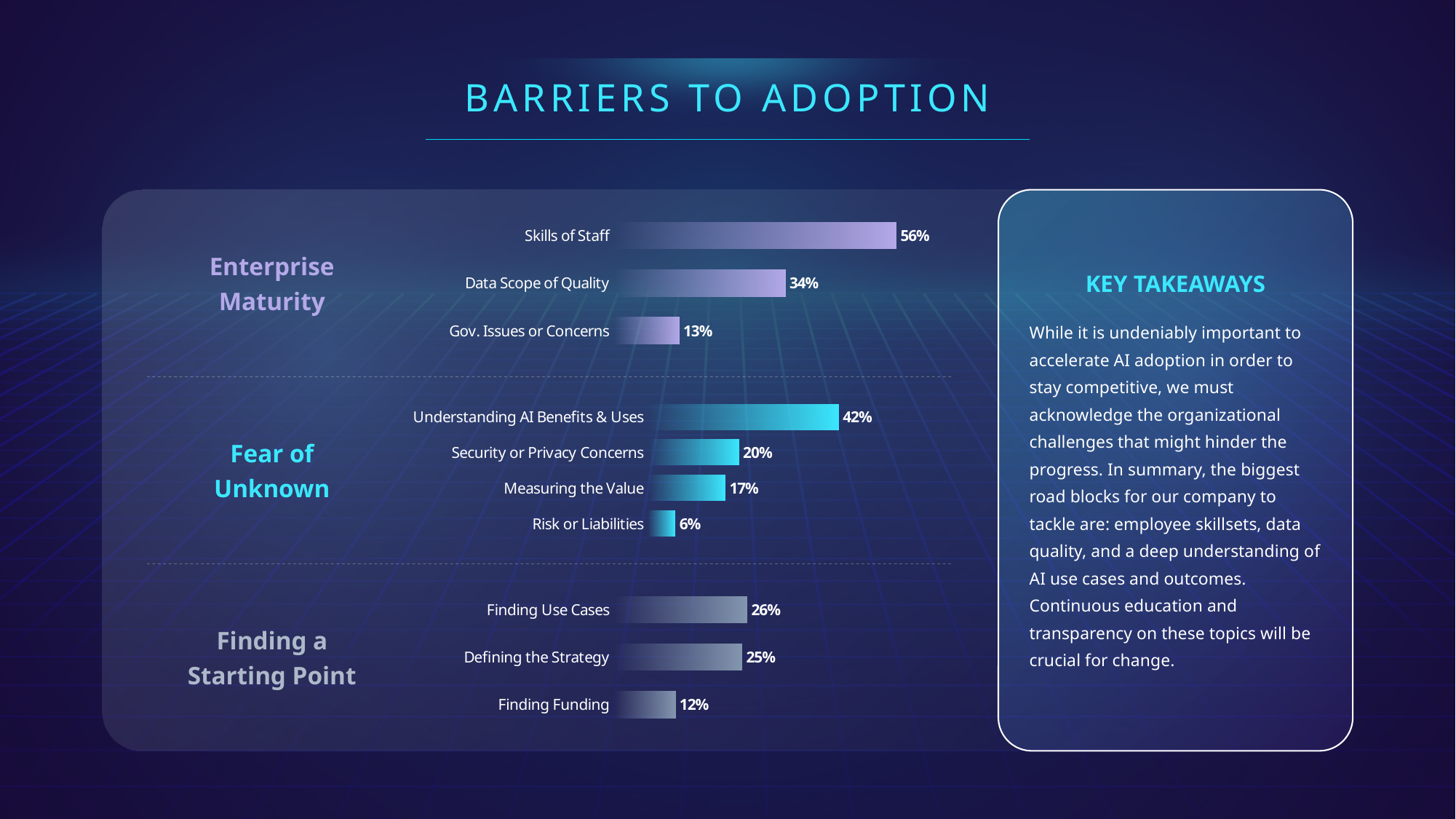
How many categories are shown in the Fear of Unknown chart? 4 What kind of chart is used in the Finding a Starting Point section? Bar chart In the Fear of Unknown chart, which is larger: Measuring the Value or Security or Privacy Concerns? Security or Privacy Concerns In the Finding a Starting Point chart, what is the difference between Finding Use Cases and Finding Funding? 14% In the Fear of Unknown chart, which category has the highest value? Understanding AI Benefits & Uses What is the title of the slide containing the charts? Barriers to Adoption In the Enterprise Maturity chart, what is the value for Skills of Staff? 56% In the Fear of Unknown chart, what is the value for Security or Privacy Concerns? 20% In the Fear of Unknown chart, which category has the lowest value? Risk or Liabilities In the Finding a Starting Point chart, what is the value for Finding Funding? 12% In the Enterprise Maturity chart, what is the value for Gov. Issues or Concerns? 13% In the Enterprise Maturity chart, what is the difference between Skills of Staff and Data Scope of Quality? 22%